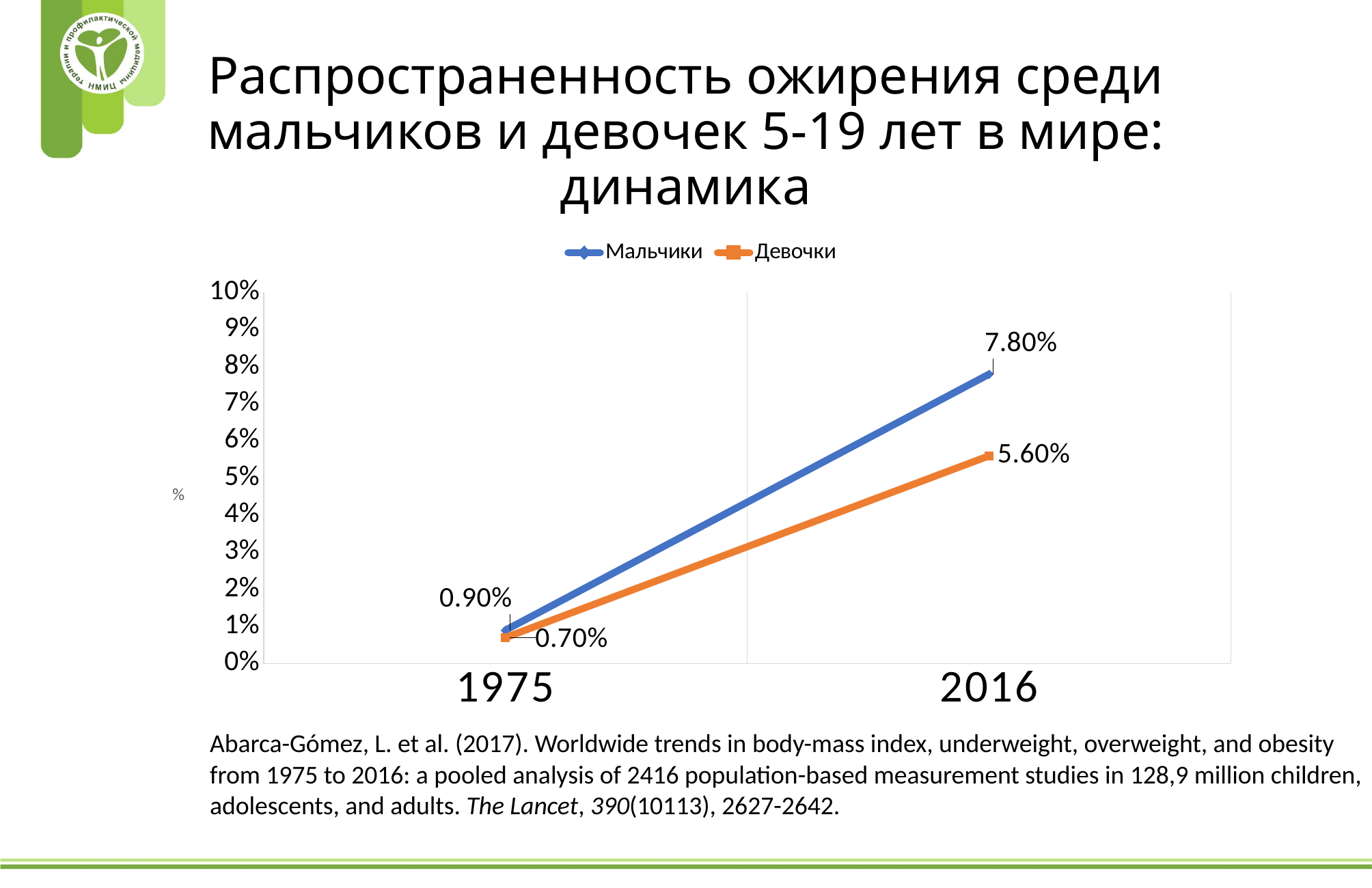
What is the difference between the Мальчики and Девочки values in 2016? 2.20% Which series has the higher value in 2016, Мальчики or Девочки? Мальчики How many years are shown on the x axis? 2 How many series does the legend list? 2 What is the value for Мальчики in 2016? 7.80% What is the value for Девочки in 2016? 5.60% What kind of chart is shown on the slide? line chart What is the value for Девочки in 1975? 0.70% By how much did the Мальчики value increase from 1975 to 2016? 6.90% Do the values for Девочки rise or fall from 1975 to 2016? rise Is the value for Девочки in 2016 greater or less than 5%? greater What is the value for Мальчики in 1975? 0.90%